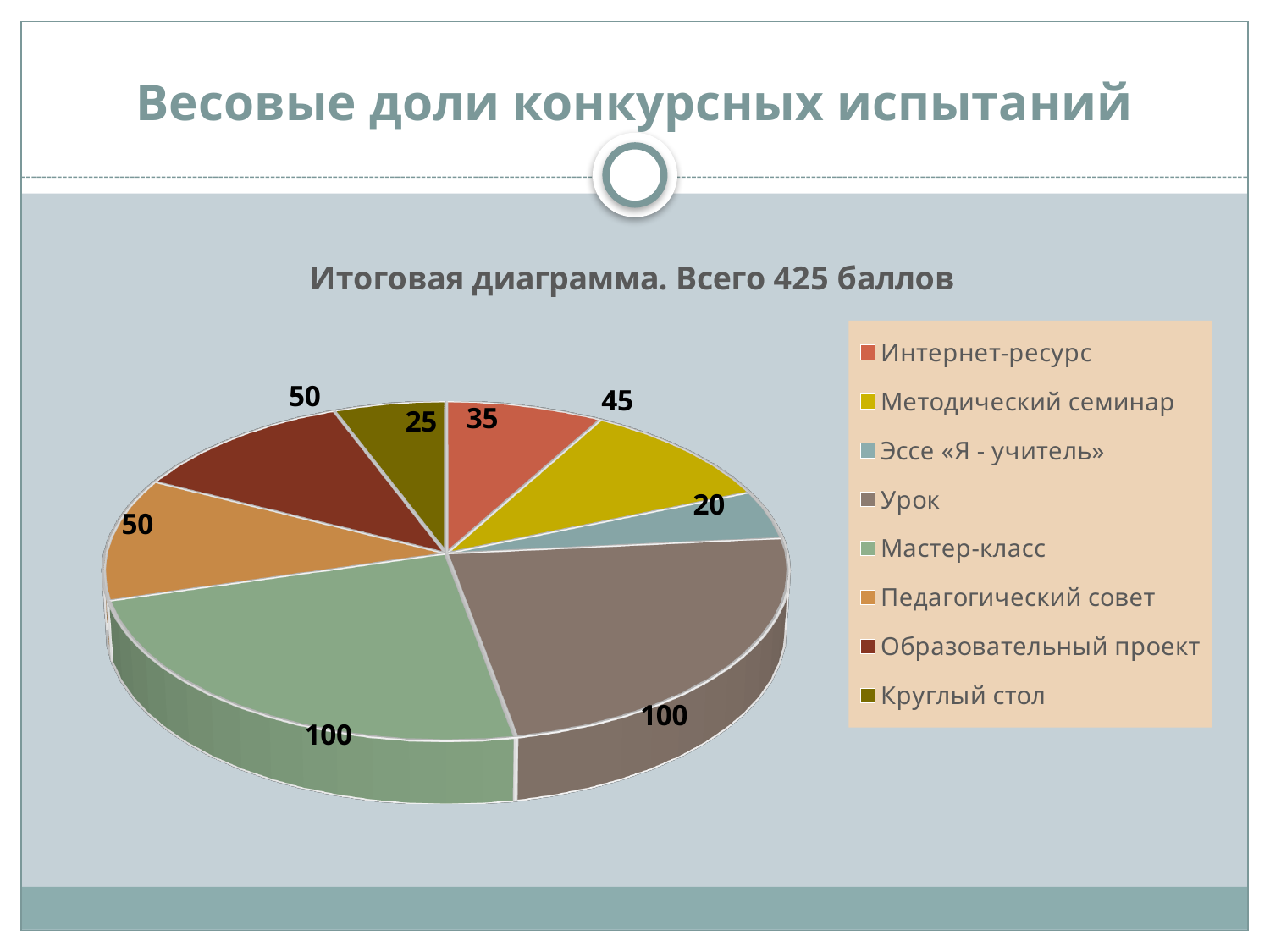
What is the difference between the values for Методический семинар and Интернет-ресурс? 10 What value is shown for Интернет-ресурс in the pie chart? 35 What type of chart is shown on the slide? Pie chart What is the total number of points stated in the chart title? 425 баллов What is the difference between the values for Урок and Эссе «Я - учитель»? 80 What value is shown for Эссе «Я - учитель»? 20 What value is shown for Педагогический совет? 50 What value is shown for Методический семинар? 45 How many categories does the pie chart show? 8 Which is larger, the value for Образовательный проект or the value for Круглый стол? Образовательный проект What value is shown for Круглый стол? 25 Which category has the smallest slice in the pie chart? Эссе «Я - учитель»